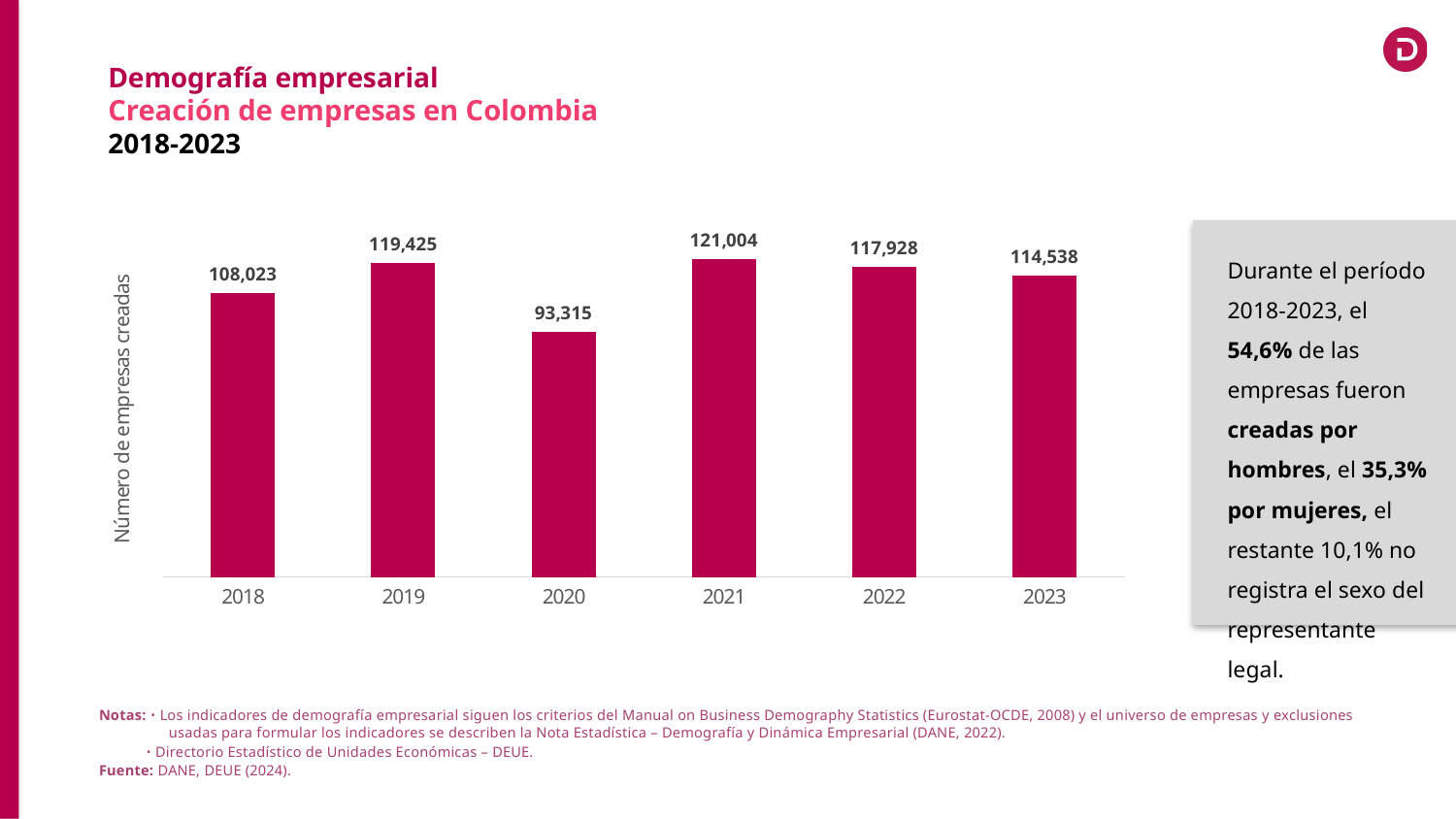
How many years (bars) are shown in the chart? 6 What type of chart is shown on the slide? Bar chart What is the difference between the values for 2021 and 2020? 27,689 Which year has a larger value, 2019 or 2022? 2019 What is the label of the vertical axis of the chart? Número de empresas creadas What is the value shown for 2018 in the chart? 108,023 Do the values rise or fall from 2021 to 2023? Fall Which year has the highest number of companies created? 2021 Which year has the lowest number of companies created? 2020 What is the number of companies created in 2023? 114,538 What is the difference between the values for 2019 and 2018? 11,402 How many companies were created in Colombia in 2020 according to the chart? 93,315